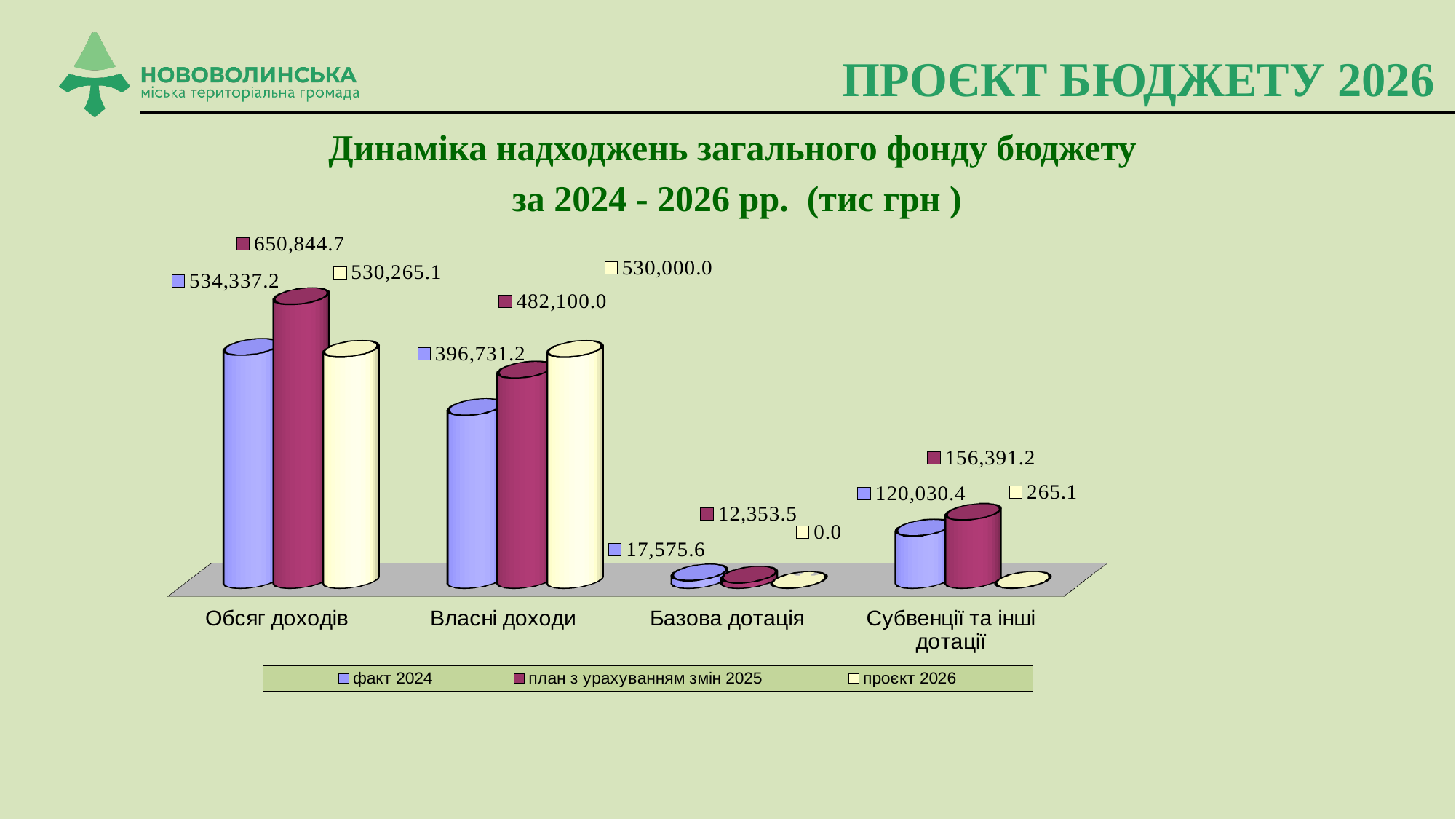
What is the value for Базова дотація in the план з урахуванням змін 2025 series? 12,353.5 What kind of chart is shown on the slide? Bar chart What is the difference between the план з урахуванням змін 2025 and факт 2024 values for Обсяг доходів? 116,507.5 Which category has the lowest value in the факт 2024 series? Базова дотація What is the value for Обсяг доходів in the факт 2024 series? 534,337.2 For Субвенції та інші дотації, which is larger: the факт 2024 value or the план з урахуванням змін 2025 value? план з урахуванням змін 2025 What is the difference between the проєкт 2026 and план з урахуванням змін 2025 values for Власні доходи? 47,900.0 How many series does the legend list? 3 What is the value for Власні доходи in the проєкт 2026 series? 530,000.0 What is the value for Субвенції та інші дотації in the проєкт 2026 series? 265.1 Which category has the highest value in the план з урахуванням змін 2025 series? Обсяг доходів How many categories are shown on the x axis? 4